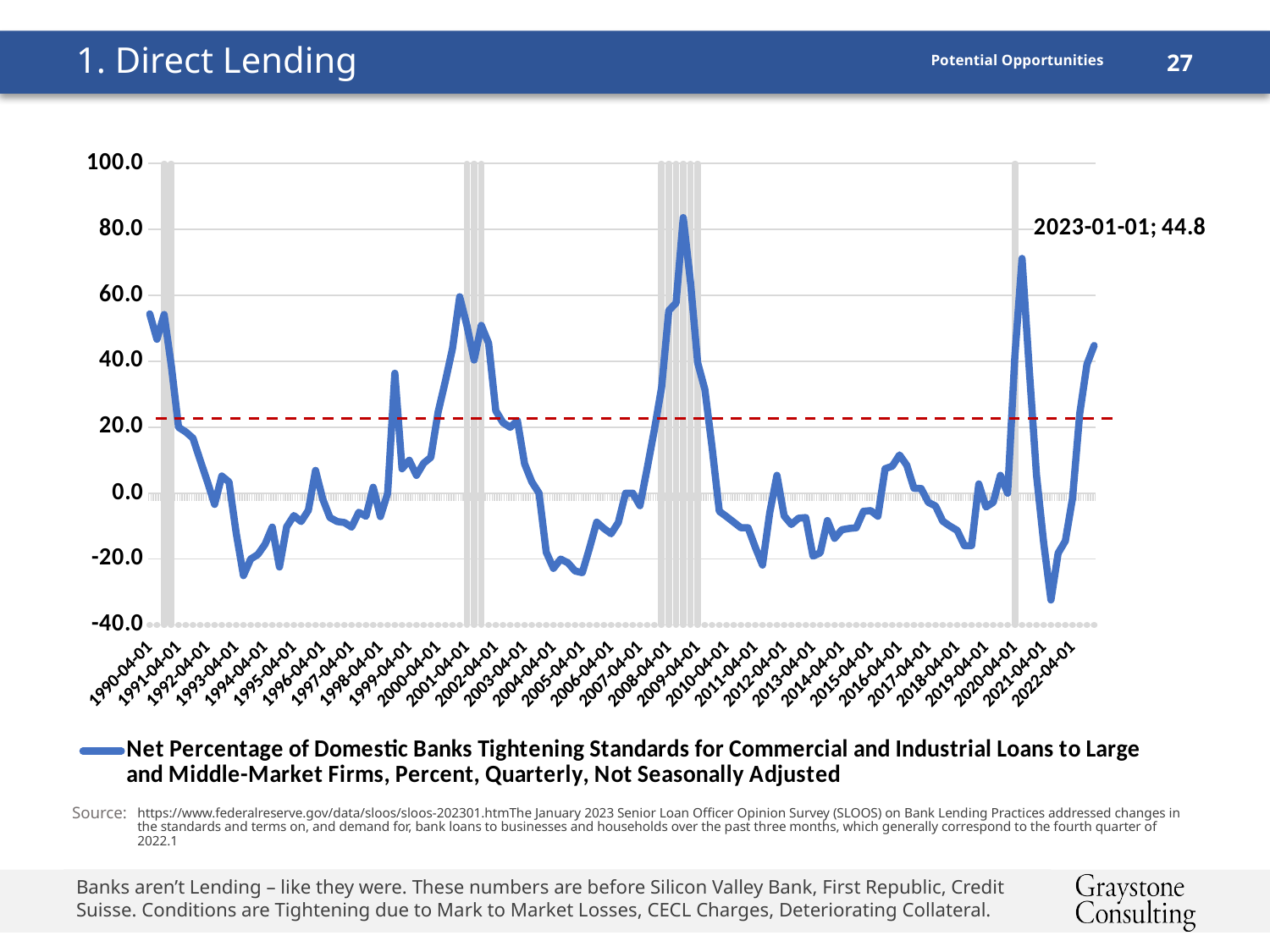
Is the peak value reached around 2008-2009 greater or less than 60? greater What colour is the horizontal dashed reference line on the chart? red Which is larger: the labelled value for 2023-01-01 or the peak around 2008-2009? the peak around 2008-2009 Is the peak value reached around 2020 greater or less than 40? greater Which is larger: the peak around 2008-2009 or the peak around 2001? the peak around 2008-2009 How many series does the legend list? 1 What kind of chart is shown on the slide? line chart Is the value at 1990-04-01 greater or less than 40? greater What value is labelled on the chart for 2023-01-01? 44.8 From the low point around 2021 to 2023-01-01, does the line rise or fall? rise